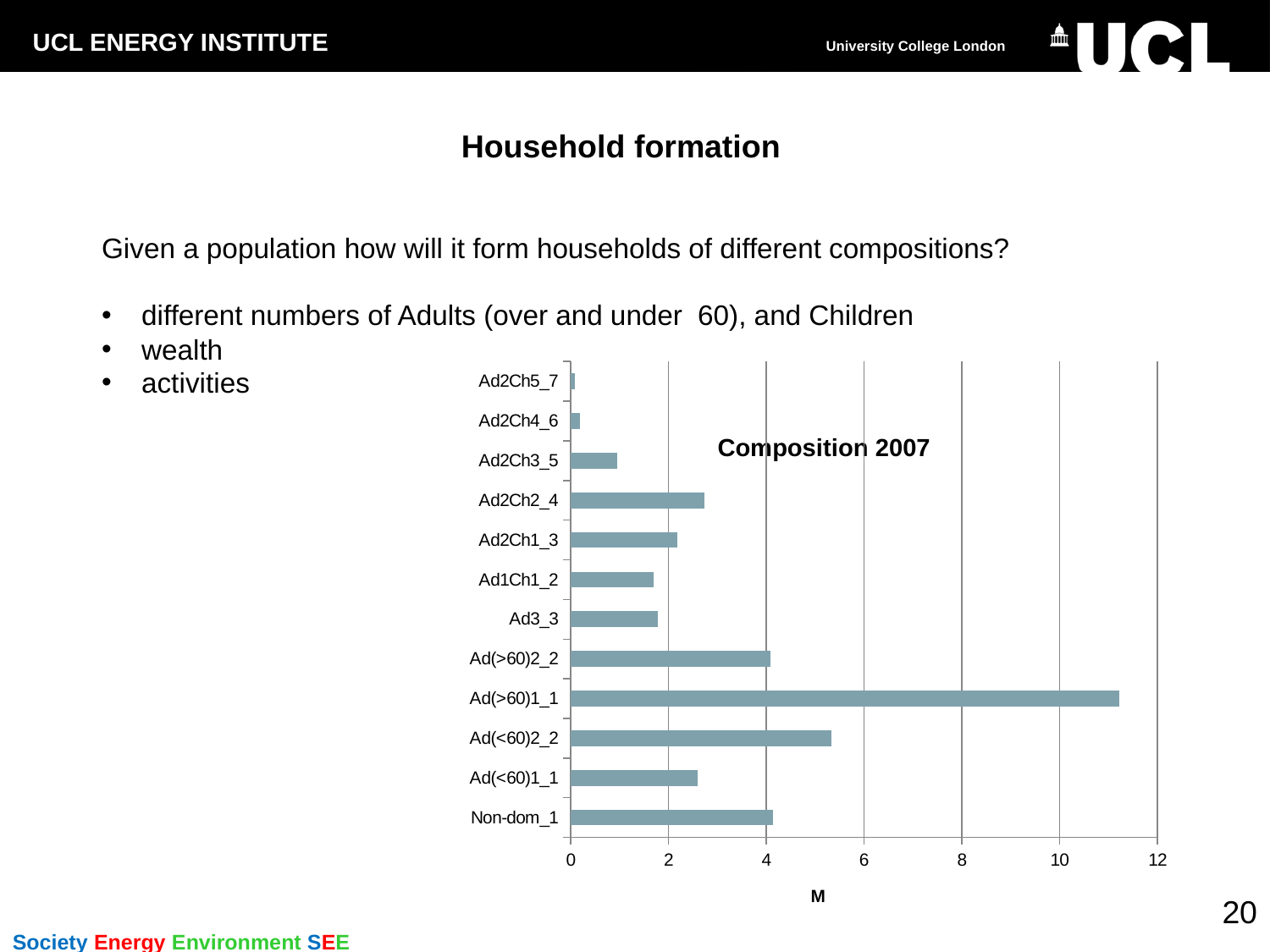
What is the title of the chart? Composition 2007 Is the value for Ad(<60)2_2 greater or less than 4? greater Which category has the lowest value in the chart? Ad2Ch5_7 Which has the larger value, Ad(<60)2_2 or Ad(>60)2_2? Ad(<60)2_2 What is the label on the horizontal axis of the chart? M Is the value for Ad2Ch3_5 greater or less than 2? less Is the value for Ad(<60)1_1 greater or less than 2? greater Which has the larger value, Ad2Ch2_4 or Ad2Ch1_3? Ad2Ch2_4 How many household composition categories are plotted in the chart? 12 What kind of chart is shown on the slide? bar chart Which category has the highest value in the chart? Ad(>60)1_1